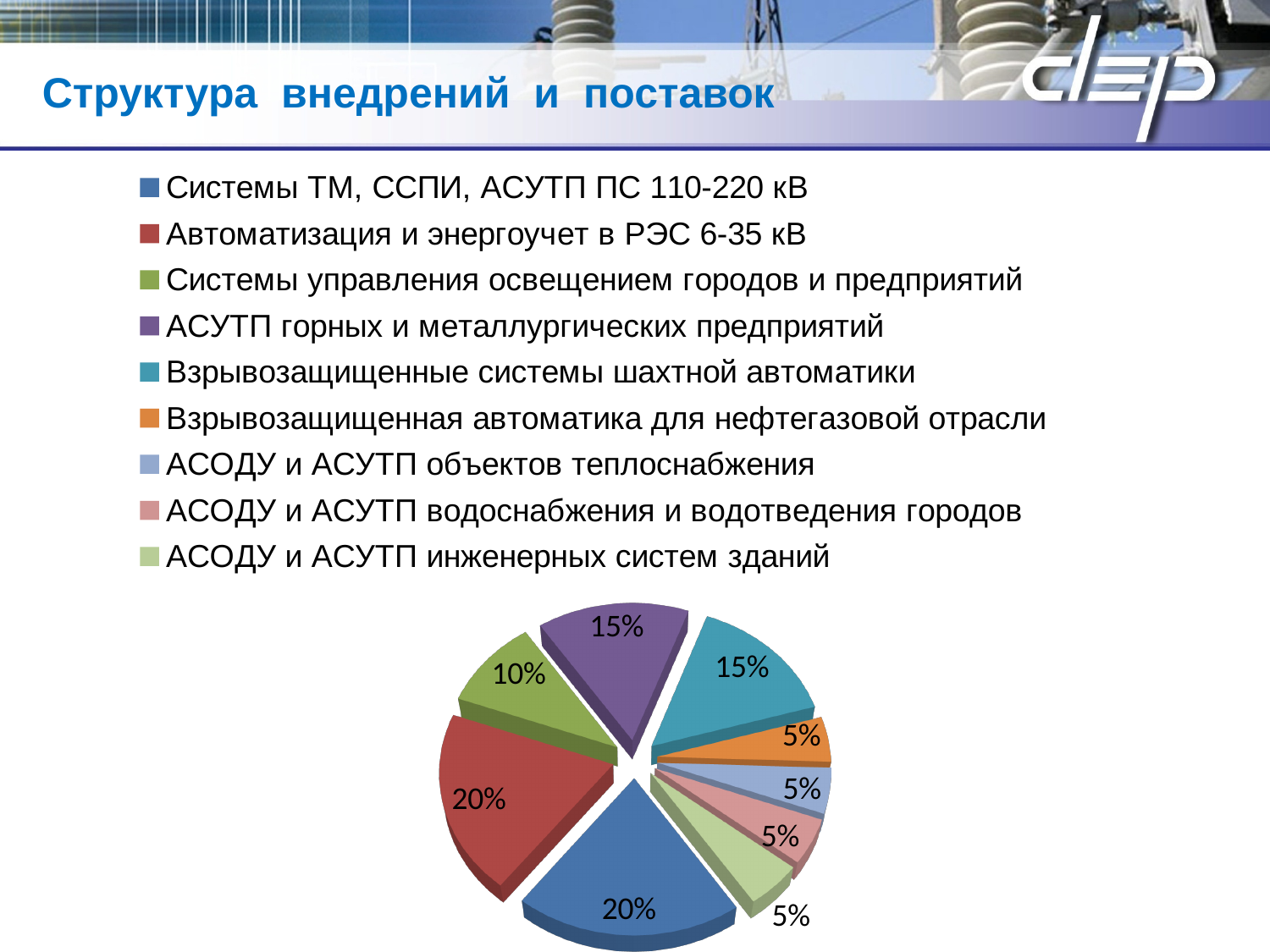
What is the value shown for "Взрывозащищенная автоматика для нефтегазовой отрасли"? 5% What is the value shown for "АСУТП горных и металлургических предприятий"? 15% What is the value shown for "Системы управления освещением городов и предприятий"? 10% How many slices does the pie chart have? 9 What share of the pie does "Системы ТМ, ССПИ, АСУТП ПС 110-220 кВ" have? 20% What colour is the slice for "АСУТП горных и металлургических предприятий"? Purple What is the difference between the share for "Автоматизация и энергоучет в РЭС 6-35 кВ" and the share for "Системы управления освещением городов и предприятий"? 10% What type of chart is shown on the slide? Pie chart How many categories does the legend of the pie chart list? 9 What share of the pie does "Автоматизация и энергоучет в РЭС 6-35 кВ" have? 20% What is the title of the slide containing the chart? Структура внедрений и поставок Which is larger: the share for "Взрывозащищенные системы шахтной автоматики" or the share for "АСОДУ и АСУТП объектов теплоснабжения"? Взрывозащищенные системы шахтной автоматики